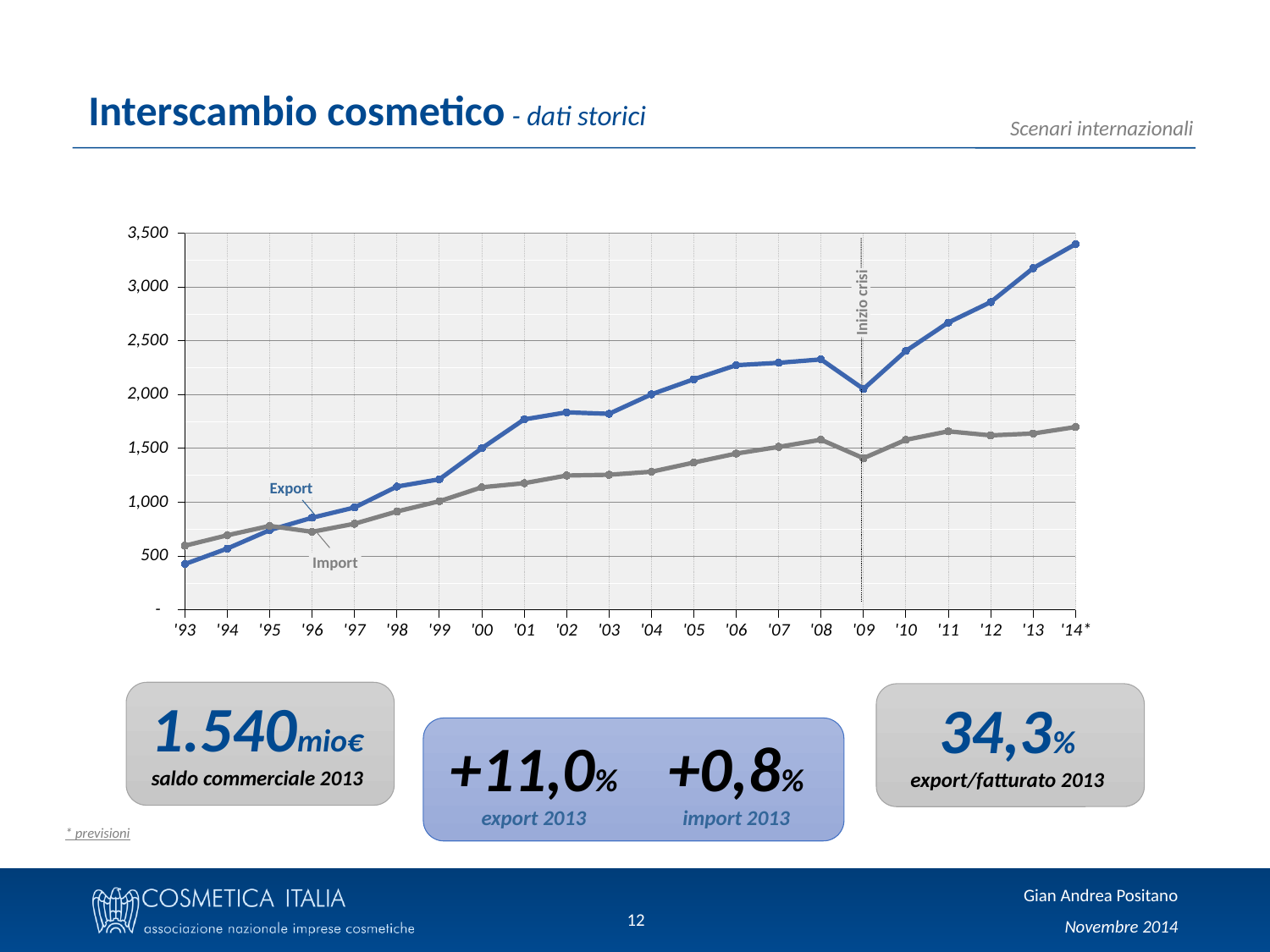
Is the Export value for '09 greater or less than 2,500? less What label is attached to the vertical dotted line at '09 in the chart? Inizio crisi In '93, which series has the larger value, Export or Import? Import What kind of chart is shown on the slide? line chart Is the Import value for '13 greater or less than 2,000? less Is the Export value for '14* greater or less than 3,000? greater In '13, which series has the larger value, Export or Import? Export How many years are shown along the x axis of the chart? 22 How many data series are plotted in the chart? 2 In which year does the Export series reach its highest value? '14*